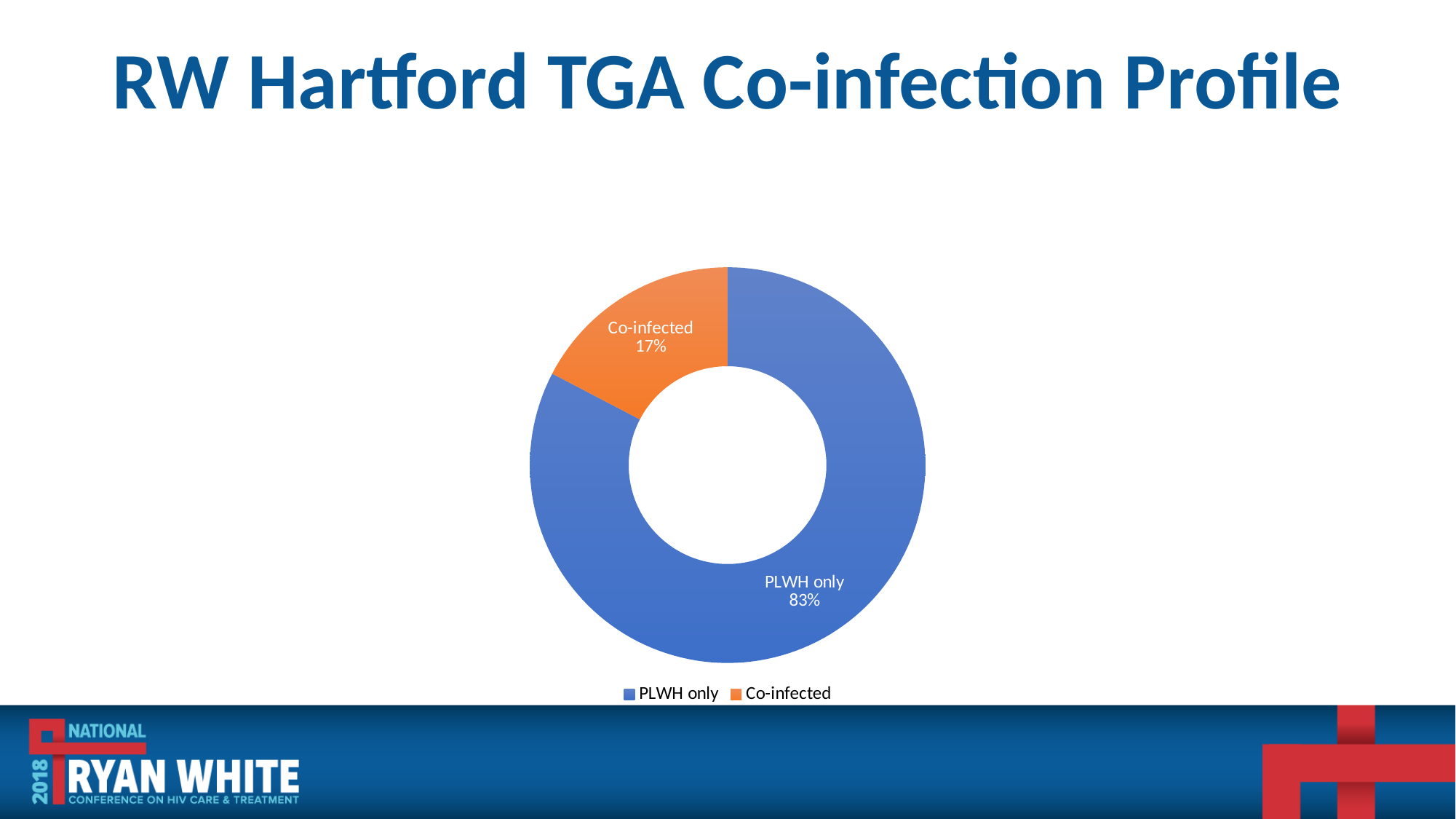
How many categories are shown in the chart? 2 How many entries does the legend list? 2 What percentage of the chart is labelled 'PLWH only'? 83% Which category has the largest share of the chart? PLWH only What is the difference in percentage points between the 'PLWH only' and 'Co-infected' shares? 66 What colour is the 'Co-infected' slice? Orange What is the title of the slide containing the chart? RW Hartford TGA Co-infection Profile What kind of chart is shown on the slide? Doughnut (pie) chart Which is larger, the 'PLWH only' share or the 'Co-infected' share? PLWH only What share of the chart does the 'Co-infected' slice represent? 17% Which category has the smallest share of the chart? Co-infected What percentage of the chart is labelled 'Co-infected'? 17%